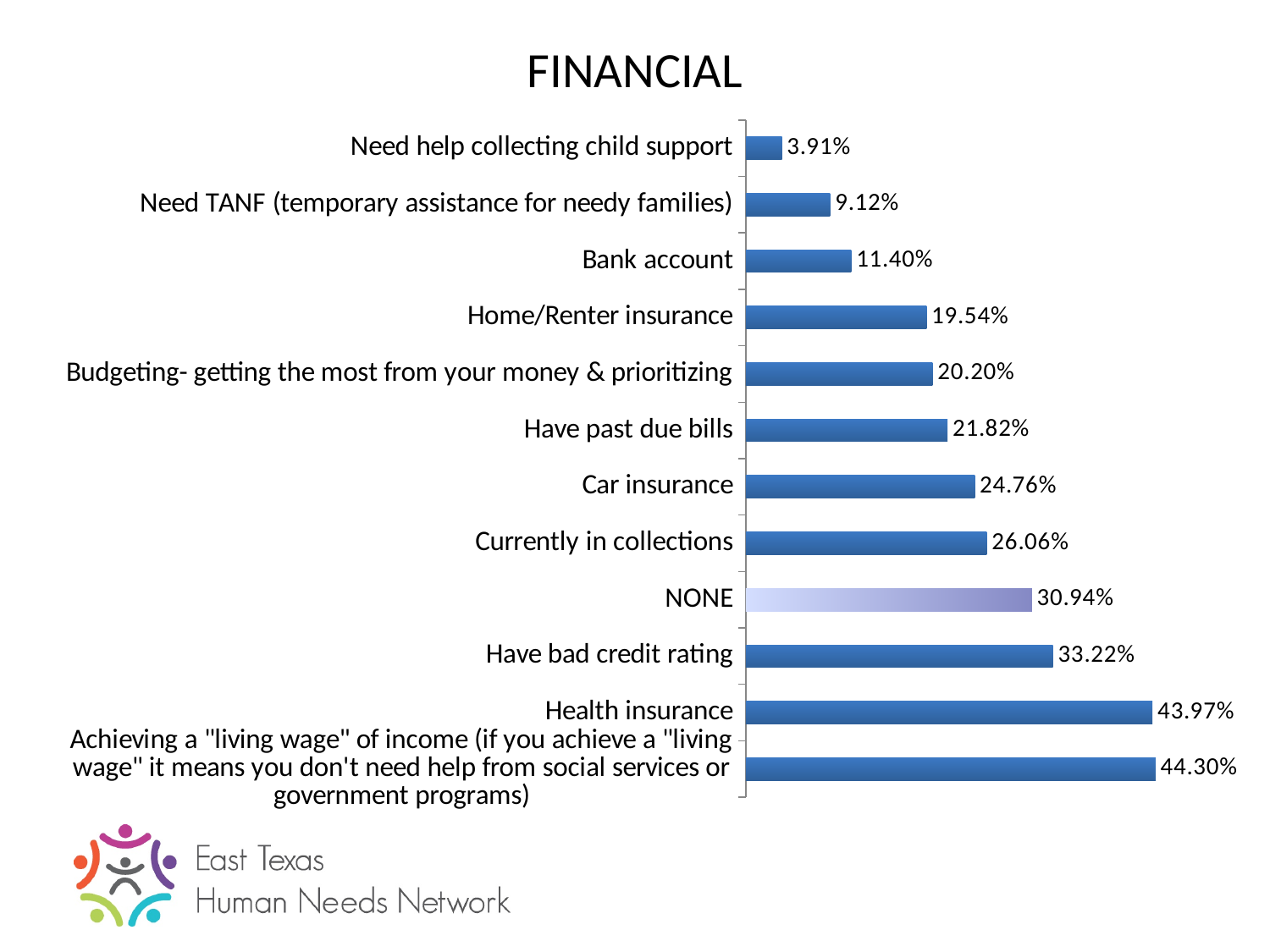
What is the value for Bank account? 11.40% What is the value for Health insurance? 43.97% What is the difference between the values for Currently in collections and Car insurance? 1.30% How many categories are shown in the chart? 12 What is the value for NONE? 30.94% What is the title of the chart? FINANCIAL What is the difference between the values for Have bad credit rating and NONE? 2.28% What is the value for Have bad credit rating? 33.22% Which category has the lowest value? Need help collecting child support What kind of chart is shown on the slide? Bar chart Which category has the highest value? Achieving a "living wage" of income Which is larger, the value for Have past due bills or the value for Home/Renter insurance? Have past due bills